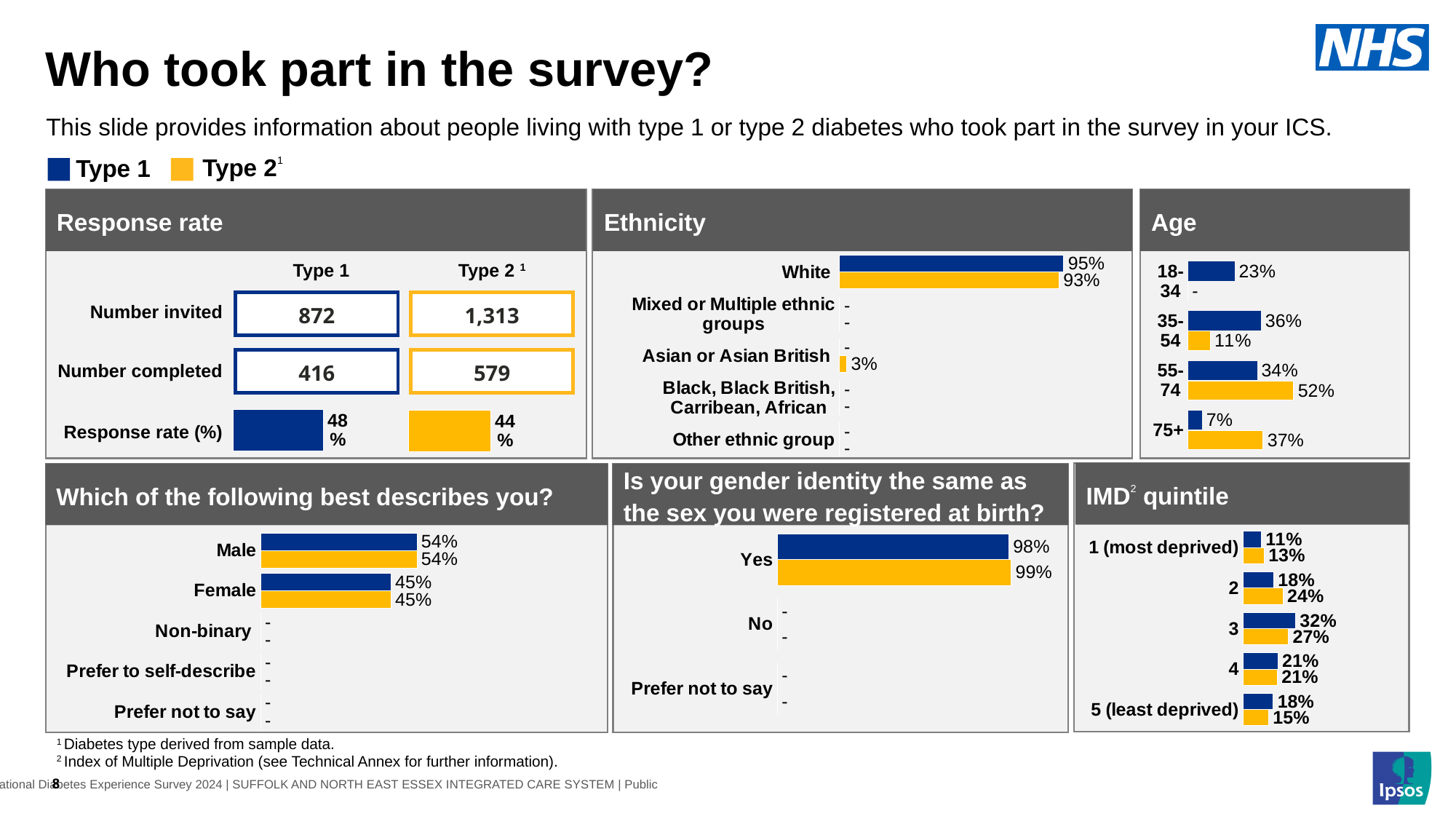
In the IMD quintile chart, what is the difference between the Type 1 and Type 2 percentages for quintile 3? 5% In the Age chart, which age group has the highest percentage of Type 1 respondents? 35-54 In the 'Which of the following best describes you?' chart, what percentage of Type 2 respondents are Female? 45% In the Ethnicity chart, what percentage of Type 1 respondents are White? 95% In the IMD quintile chart, is the Type 2 percentage for quintile 2 larger or smaller than the Type 1 percentage? larger In the gender identity chart, what percentage of Type 2 respondents answered Yes? 99% In the Age chart, which age group has the lowest percentage of Type 1 respondents? 75+ In the IMD quintile chart, which quintile has the highest percentage of Type 1 respondents? 3 In the Age chart, what percentage of Type 2 respondents are aged 55-74? 52% How many series does the legend at the top of the slide list? 2 In the Age chart, what is the difference between the Type 2 and Type 1 percentages for the 75+ age group? 30% In the Ethnicity chart, what percentage of Type 2 respondents are Asian or Asian British? 3%